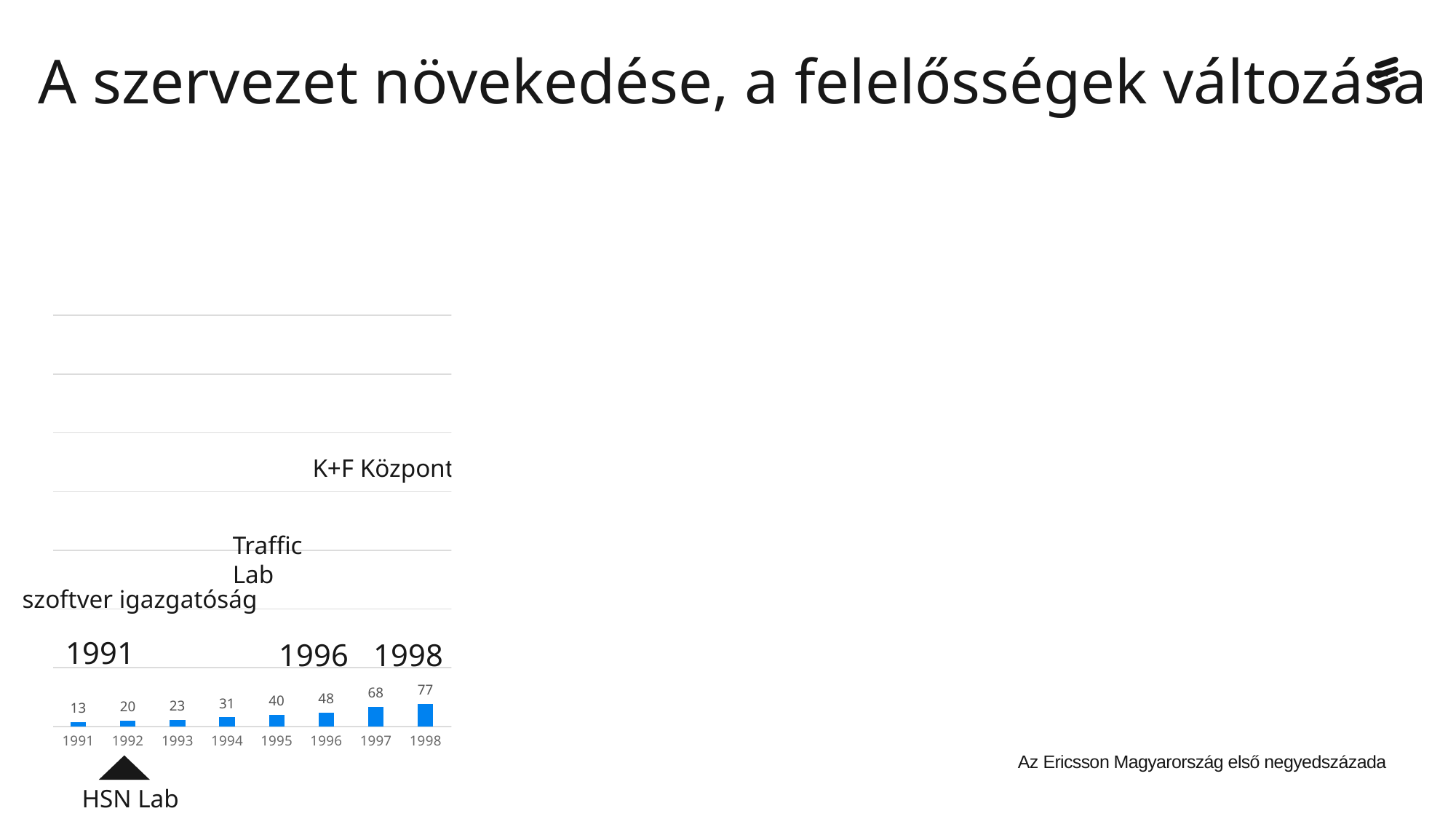
Do the values rise or fall from 1991 to 1998? rise How many years are shown on the x axis of the chart? 8 Which year has the highest value? 1998 What colour are the bars in the chart? blue Which year has the lowest value? 1991 Which is larger, the value for 1993 or the value for 1994? 1994 What is the difference between the values for 1998 and 1997? 9 What kind of chart is shown on the slide? bar chart What is the value for 1995? 40 What is the value for 1991? 13 What is the difference between the values for 1996 and 1991? 35 What is the value for 1998? 77